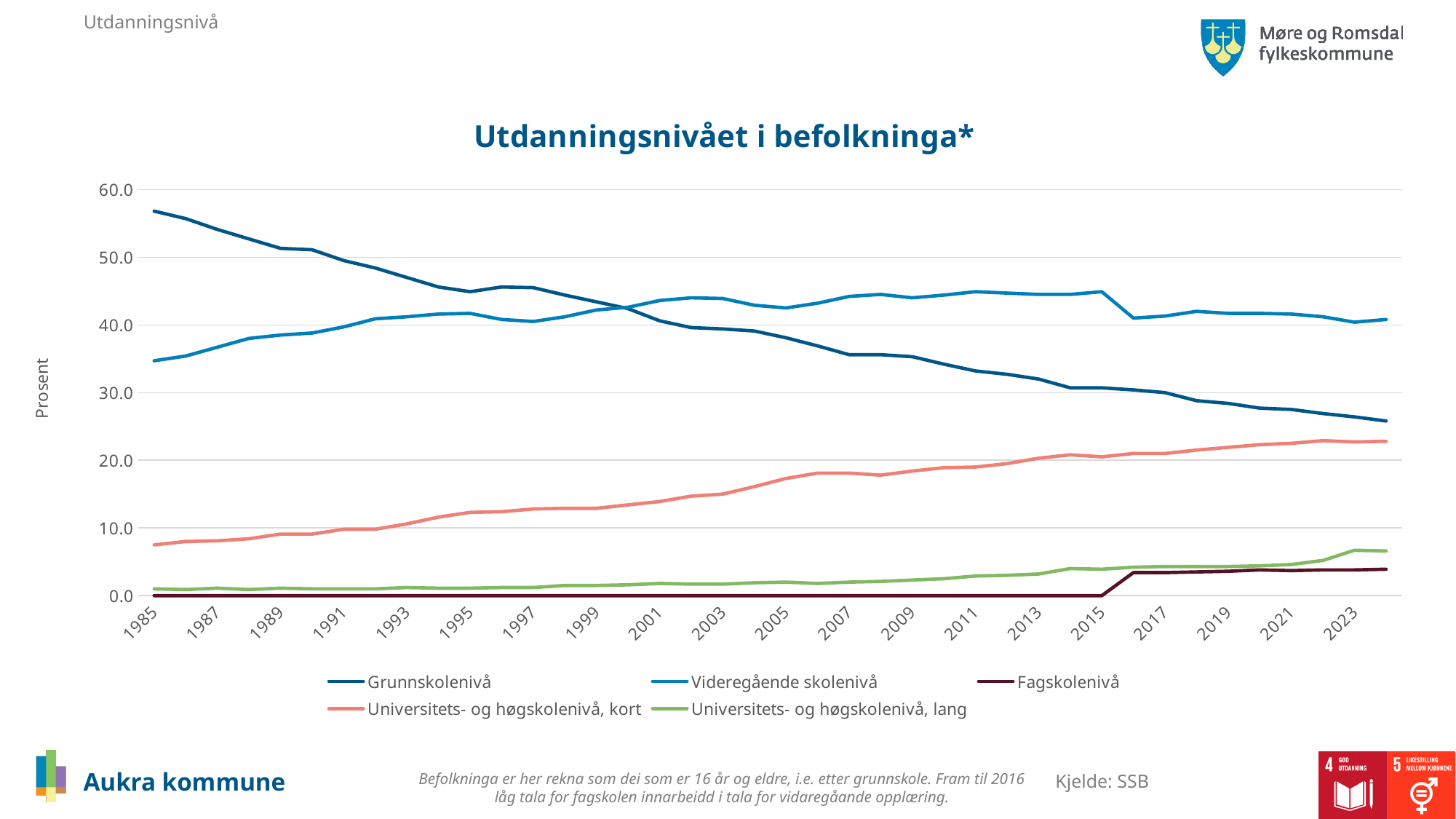
Does the Grunnskolenivå line rise or fall from 1985 to 2023? fall Is the value for Grunnskolenivå in 2023 greater or less than 30? less Which series has the highest value in 2023? Videregående skolenivå Does the Universitets- og høgskolenivå, kort line rise or fall from 1985 to 2023? rise What kind of chart is shown on the slide? line chart Is the value for Universitets- og høgskolenivå, kort in 2023 greater or less than 20? greater What is the title of the chart? Utdanningsnivået i befolkninga* In 1985, which is larger: Grunnskolenivå or Videregående skolenivå? Grunnskolenivå How many series does the legend list? 5 Is the value for Grunnskolenivå in 1985 greater or less than 50? greater What is the label on the vertical axis? Prosent